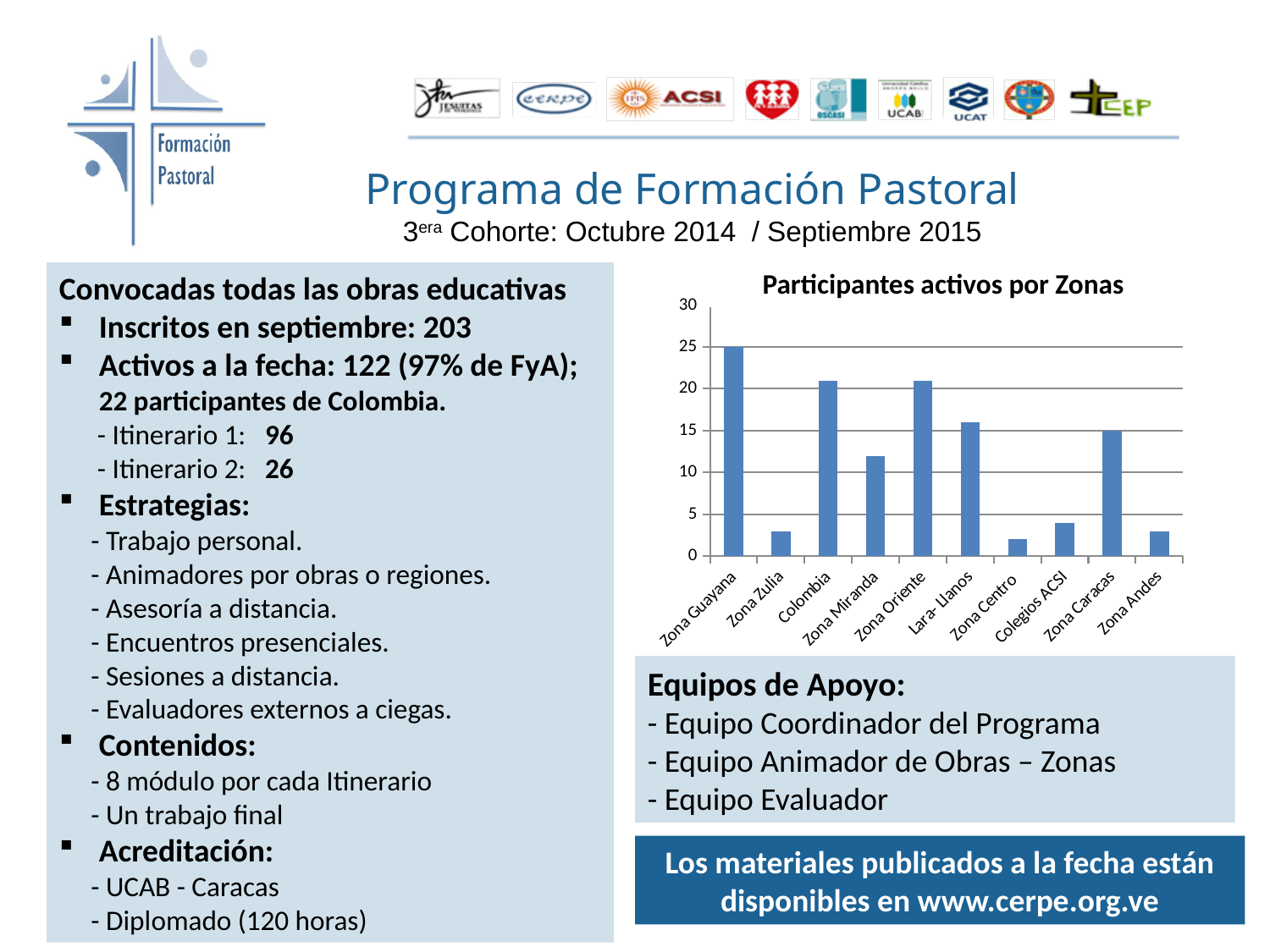
Which zone has the highest number of active participants in the chart? Zona Guayana How many zones (categories) are shown on the x axis of the chart? 10 Is the value for Zona Miranda greater or less than 15? less Is the value for Zona Zulia greater or less than 5? less What is the value for Zona Caracas in the chart? 15 What is the title of the chart on the slide? Participantes activos por Zonas Which has a larger value, Zona Oriente or Zona Centro? Zona Oriente What kind of chart is shown on the slide? bar chart What is the difference between the values for Zona Guayana and Zona Caracas? 10 What is the value for Zona Guayana in the chart? 25